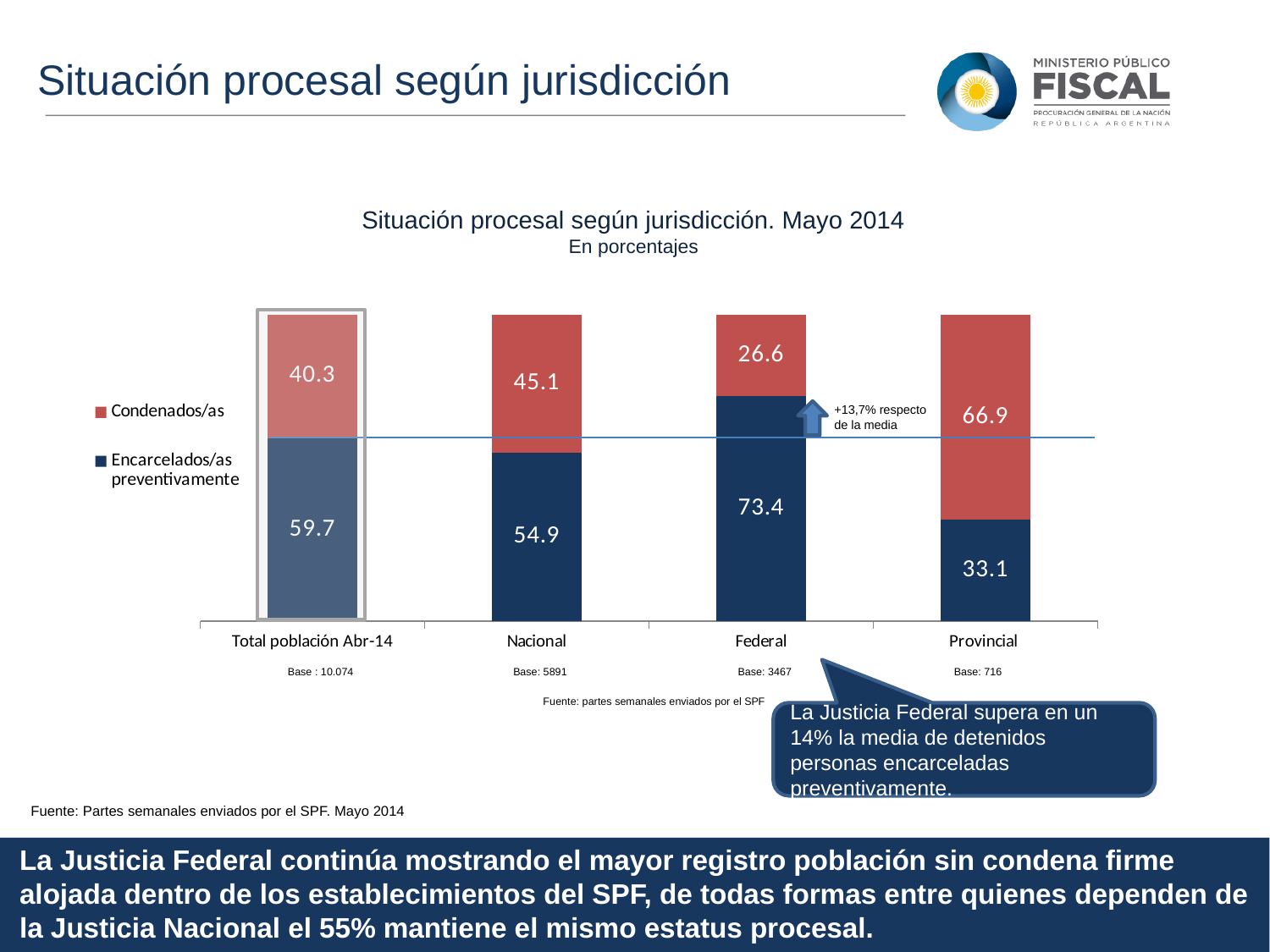
What is the value for Encarcelados/as preventivamente in the Federal category? 73.4 Which category has the lowest value for Condenados/as? Federal What kind of chart is shown on the slide? Stacked bar chart How many series does the legend list? 2 How many categories are shown on the x axis? 4 Which is larger: the Condenados/as value for Provincial or for Nacional? Provincial What is the value for Condenados/as in the Provincial category? 66.9 What is the value for Condenados/as in the Total población Abr-14 category? 40.3 Which category has the highest value for Encarcelados/as preventivamente? Federal What is the total of the stacked bar for the Provincial category? 100 What is the value for Encarcelados/as preventivamente in the Nacional category? 54.9 What is the difference between the Encarcelados/as preventivamente values for Federal and Nacional? 18.5